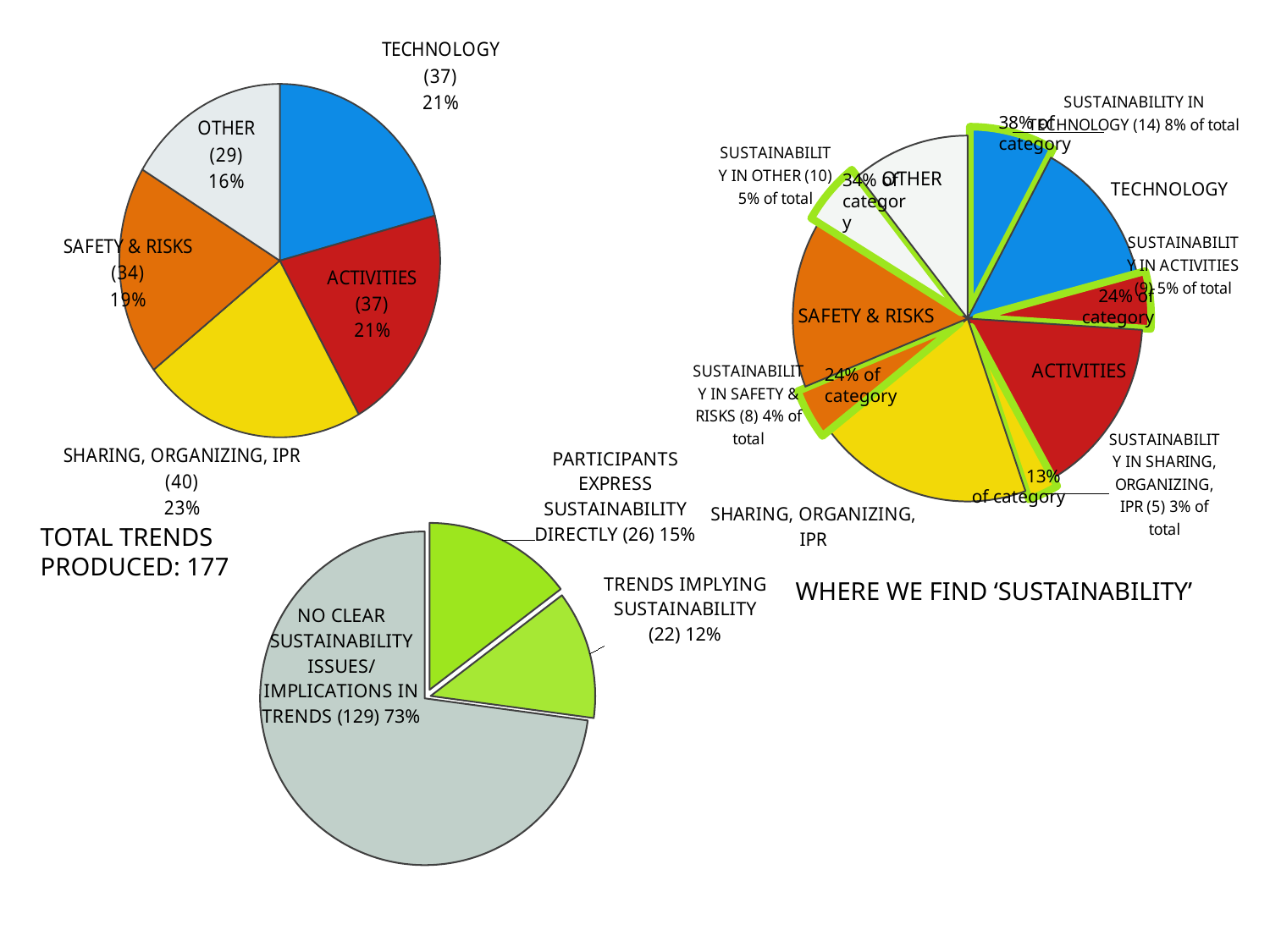
How many categories does the top-left pie chart show? 5 In the 'WHERE WE FIND SUSTAINABILITY' pie chart, how many trends are counted as SUSTAINABILITY IN TECHNOLOGY? 14 What type of chart is used for the bottom-left chart? Pie chart In the 'WHERE WE FIND SUSTAINABILITY' pie chart, what percentage of the total is SUSTAINABILITY IN SAFETY & RISKS? 4% of total In the top-left pie chart, which category has the smallest number of trends? OTHER In the bottom-left pie chart, what percentage of trends are ones where participants express sustainability directly? 15% In the bottom-left pie chart, how many trends have no clear sustainability issues/implications? 129 In the bottom-left pie chart, which is larger: PARTICIPANTS EXPRESS SUSTAINABILITY DIRECTLY or TRENDS IMPLYING SUSTAINABILITY? PARTICIPANTS EXPRESS SUSTAINABILITY DIRECTLY In the top-left pie chart, how many trends are in the SHARING, ORGANIZING, IPR category? 40 In the top-left pie chart, which category has the largest number of trends? SHARING, ORGANIZING, IPR In the top-left pie chart, what is the difference between the number of trends in SHARING, ORGANIZING, IPR and in SAFETY & RISKS? 6 In the top-left pie chart, what percentage share does OTHER have? 16%